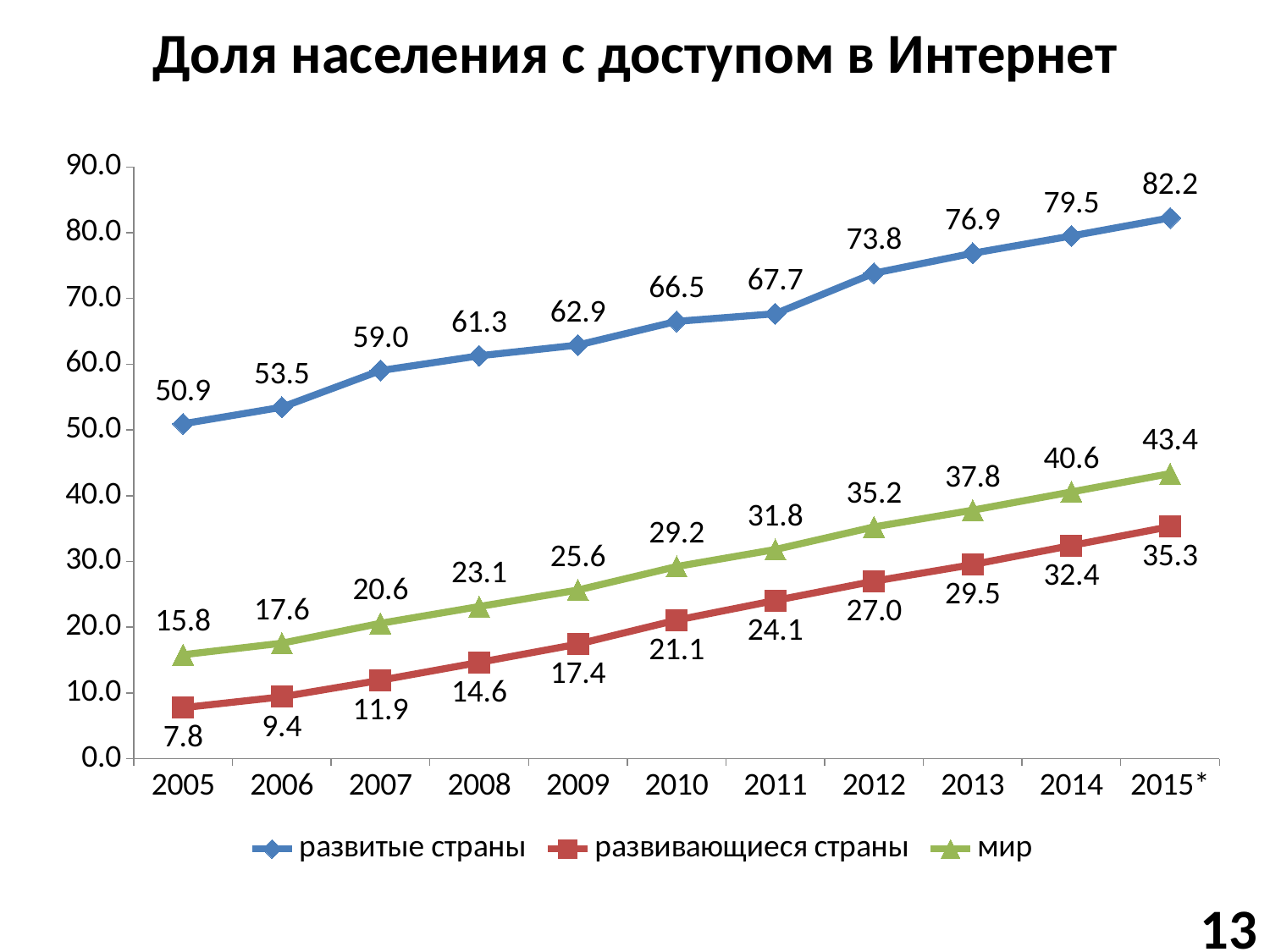
How many years are shown on the x axis? 11 How many series does the legend list? 3 In which year is the value for мир the lowest? 2005 In which year is the value for развивающиеся страны the highest? 2015* Do the values for развитые страны rise or fall from 2005 to 2015*? rise What is the difference between the мир value and the развивающиеся страны value in 2012? 8.2 What is the difference between the развитые страны value in 2015* and in 2005? 31.3 What is the value for развитые страны in 2010? 66.5 What kind of chart is shown on the slide? line chart Which series has the larger value in 2009: развивающиеся страны or мир? мир What is the value for развивающиеся страны in 2008? 14.6 What is the value for мир in 2013? 37.8